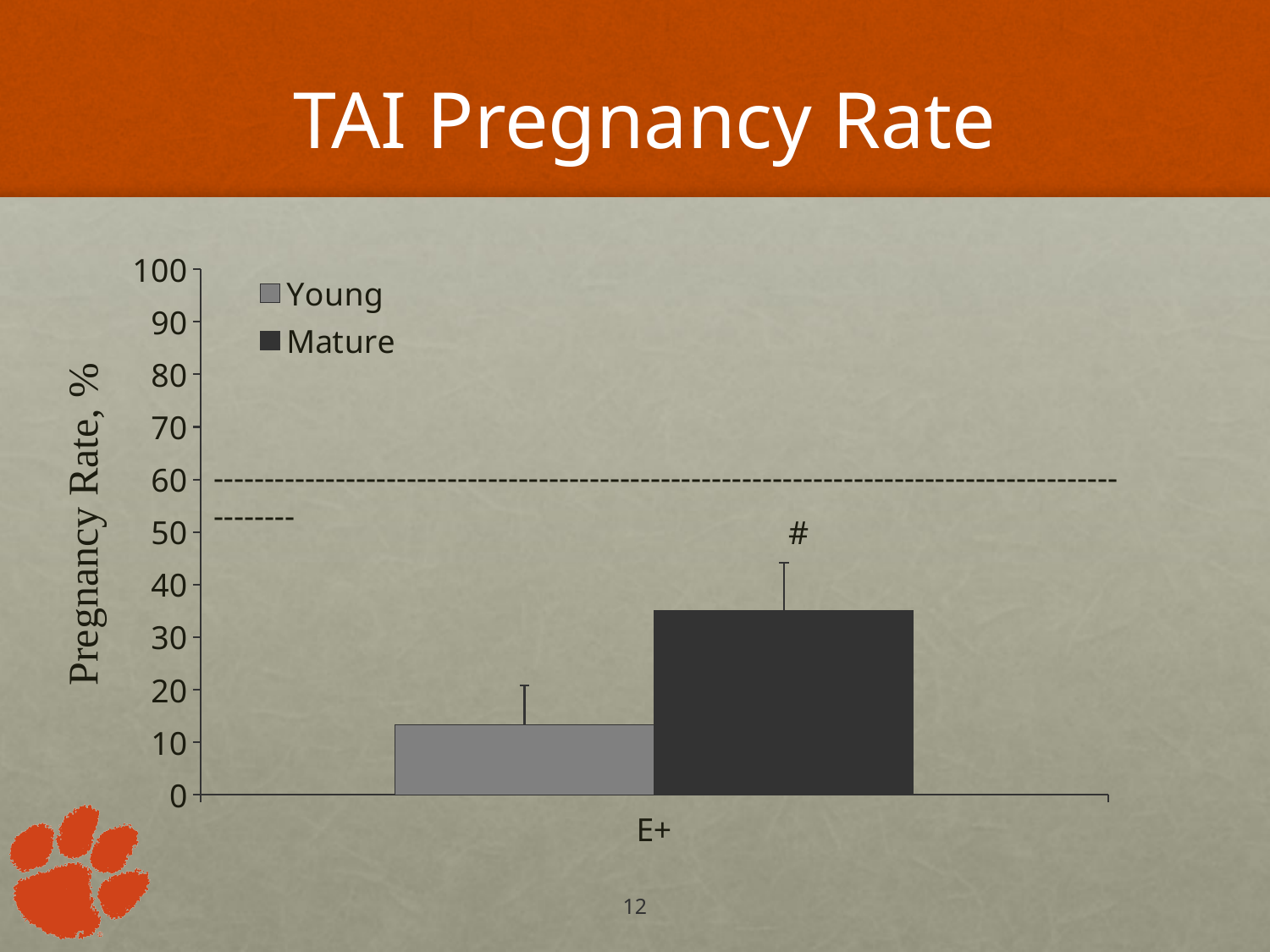
Which series has the lowest bar in the chart? Young Is the value for Mature greater or less than 30? greater Is the value for Young greater or less than 10? greater Is the value for Young greater or less than 20? less Which series has the higher pregnancy rate for E+, Young or Mature? Mature Which series has the highest bar in the chart? Mature What is the label of the y axis? Pregnancy Rate, % How many series does the legend list? 2 What kind of chart is shown on the slide? bar chart How many categories are shown on the x axis? 1 What is the title of the chart? TAI Pregnancy Rate